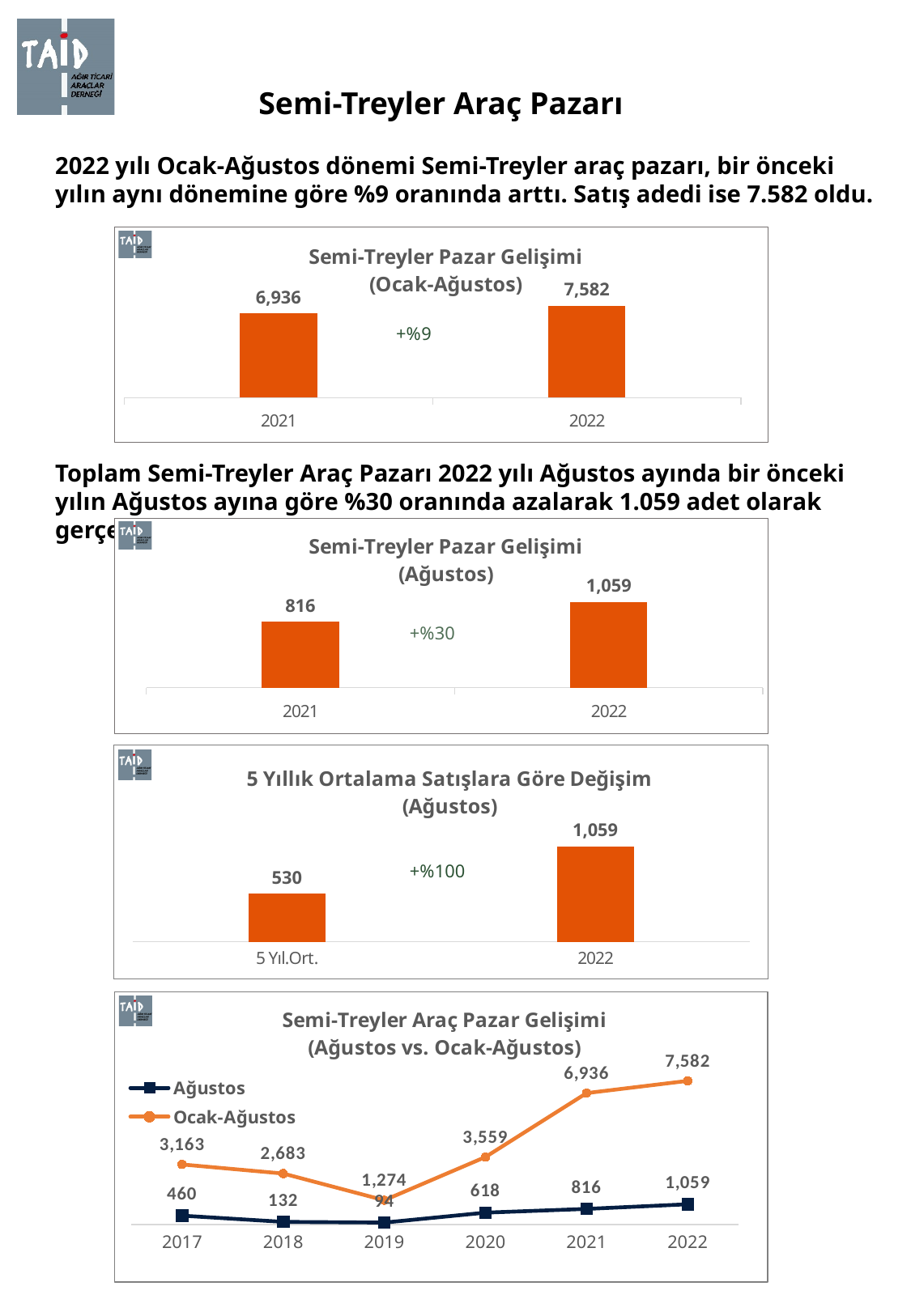
In the '5 Yıllık Ortalama Satışlara Göre Değişim (Ağustos)' chart, what is the value for '5 Yıl.Ort.'? 530 In the '5 Yıllık Ortalama Satışlara Göre Değişim (Ağustos)' chart, what percentage change is shown between the two bars? +%100 In the 'Semi-Treyler Araç Pazar Gelişimi (Ağustos vs. Ocak-Ağustos)' chart, does the Ocak-Ağustos series rise or fall from 2019 to 2022? rise In the 'Semi-Treyler Pazar Gelişimi (Ocak-Ağustos)' chart, what is the value for 2022? 7,582 In the 'Semi-Treyler Pazar Gelişimi (Ocak-Ağustos)' chart, what is the difference between the 2022 and 2021 values? 646 In the 'Semi-Treyler Araç Pazar Gelişimi (Ağustos vs. Ocak-Ağustos)' chart, how many years are shown on the x axis? 6 In the 'Semi-Treyler Araç Pazar Gelişimi (Ağustos vs. Ocak-Ağustos)' chart, which year has the lowest Ağustos value? 2019 In the 'Semi-Treyler Araç Pazar Gelişimi (Ağustos vs. Ocak-Ağustos)' chart, what is the Ocak-Ağustos value for 2019? 1,274 In the 'Semi-Treyler Pazar Gelişimi (Ağustos)' chart, which year has the higher value, 2021 or 2022? 2022 How many series does the legend of the 'Semi-Treyler Araç Pazar Gelişimi (Ağustos vs. Ocak-Ağustos)' chart list? 2 What kind of chart is 'Semi-Treyler Araç Pazar Gelişimi (Ağustos vs. Ocak-Ağustos)'? line chart In the 'Semi-Treyler Pazar Gelişimi (Ağustos)' chart, what is the value for 2021? 816